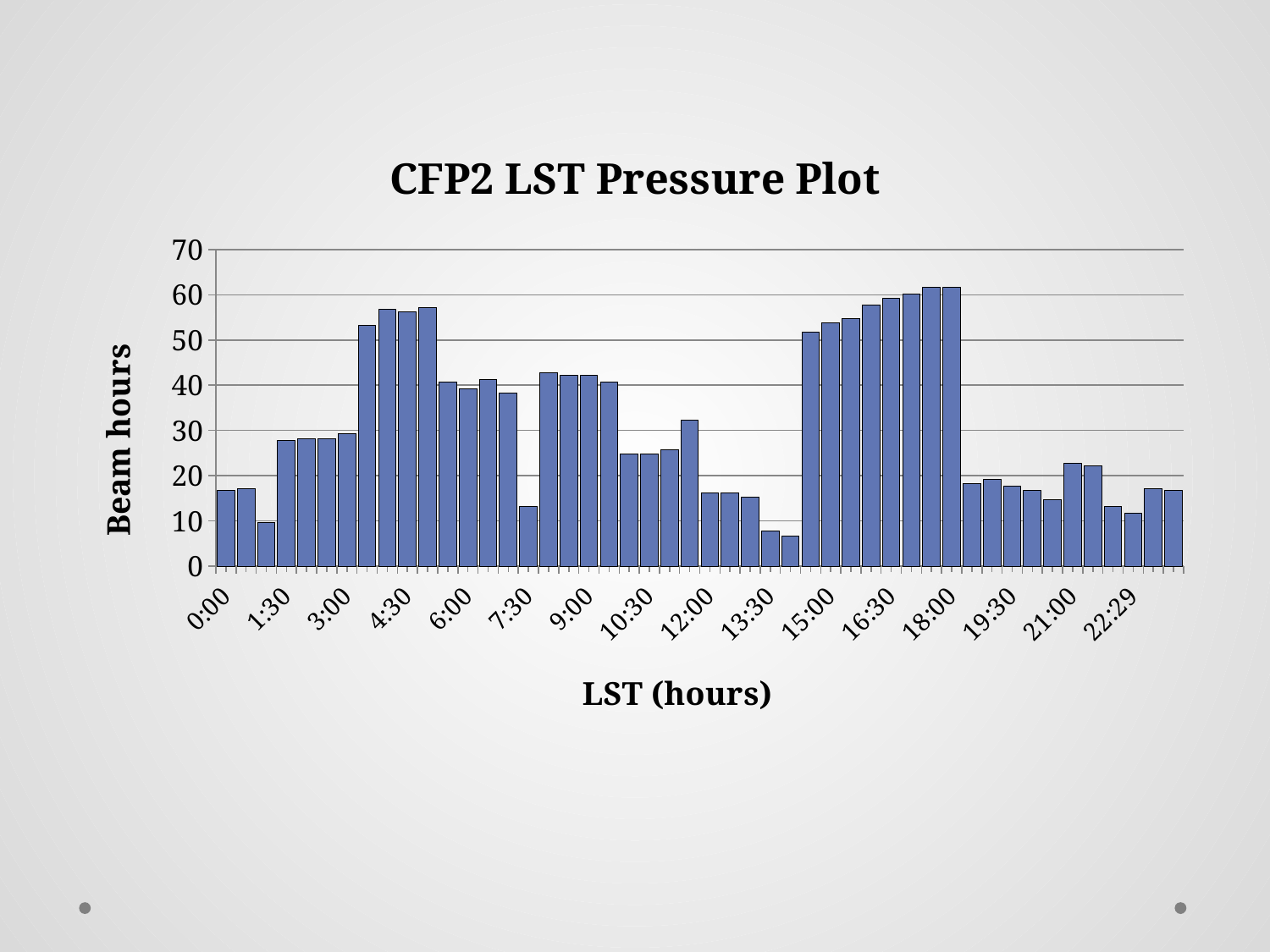
Which has the larger value, 4:30 or 0:00? 4:30 What is the label on the vertical axis of the chart? Beam hours Which has the larger value, 16:30 or 7:30? 16:30 Do the values rise or fall from 15:00 to 16:30? rise What kind of chart is the CFP2 LST Pressure Plot? bar chart Is the value for 0:00 greater or less than 20? less Is the value for 21:00 greater or less than 30? less Is the value for 13:30 greater or less than 10? less What is the title of the chart? CFP2 LST Pressure Plot